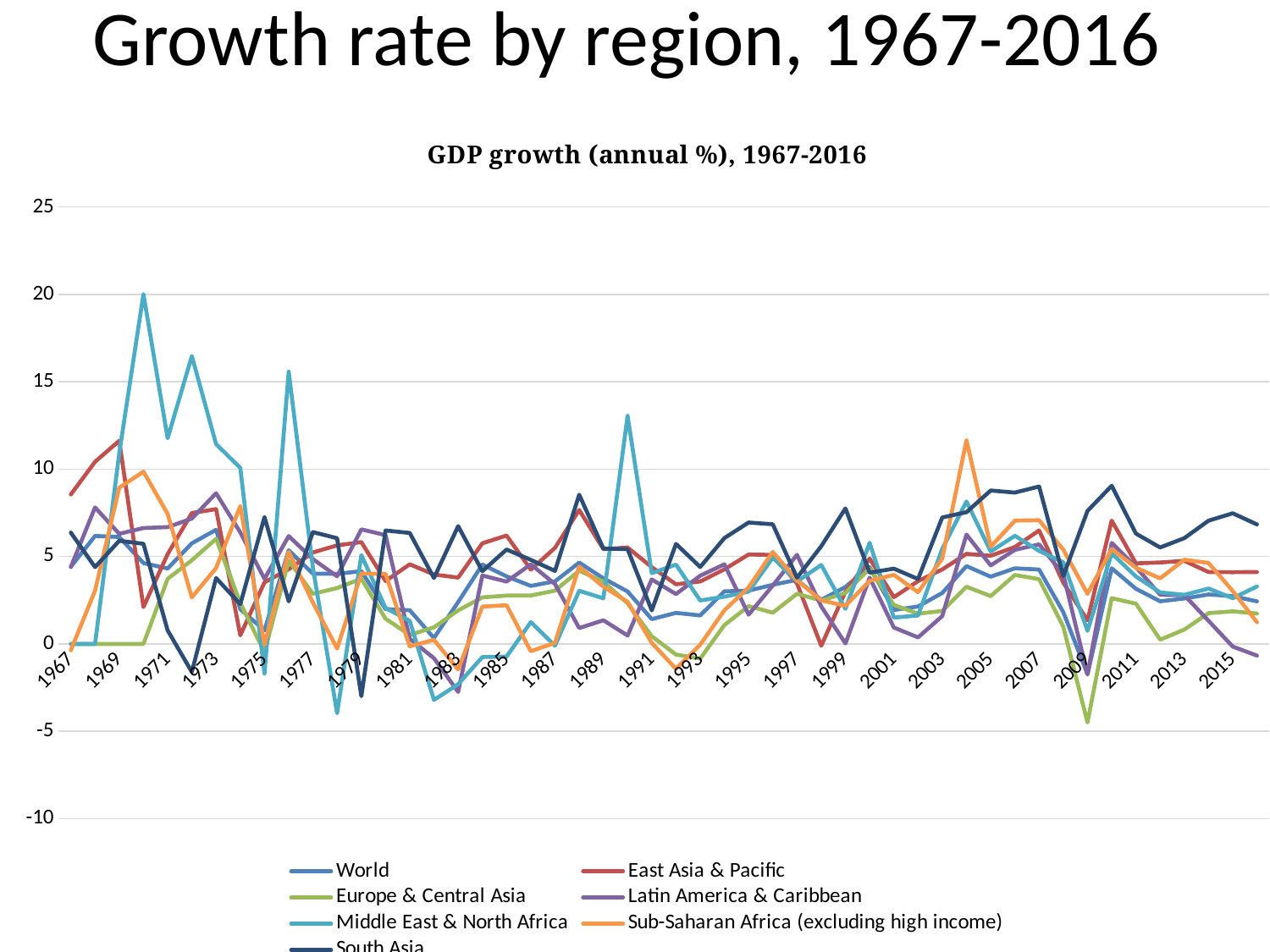
Which series reaches the highest value anywhere on the chart? Middle East & North Africa Is the value for Europe & Central Asia in 2009 greater or less than 0? less Is the value for Middle East & North Africa in 1970 greater or less than 15? greater In 1970, which is higher: Middle East & North Africa or East Asia & Pacific? Middle East & North Africa Is the value for Middle East & North Africa in 1990 greater or less than 10? greater What is the title of the chart? GDP growth (annual %), 1967-2016 Which series is drawn in orange? Sub-Saharan Africa (excluding high income) How many series does the legend list? 7 What kind of chart is shown on the slide? line chart In 2009, which is higher: Europe & Central Asia or World? World How many years does the x axis cover, from 1967 to 2016? 50